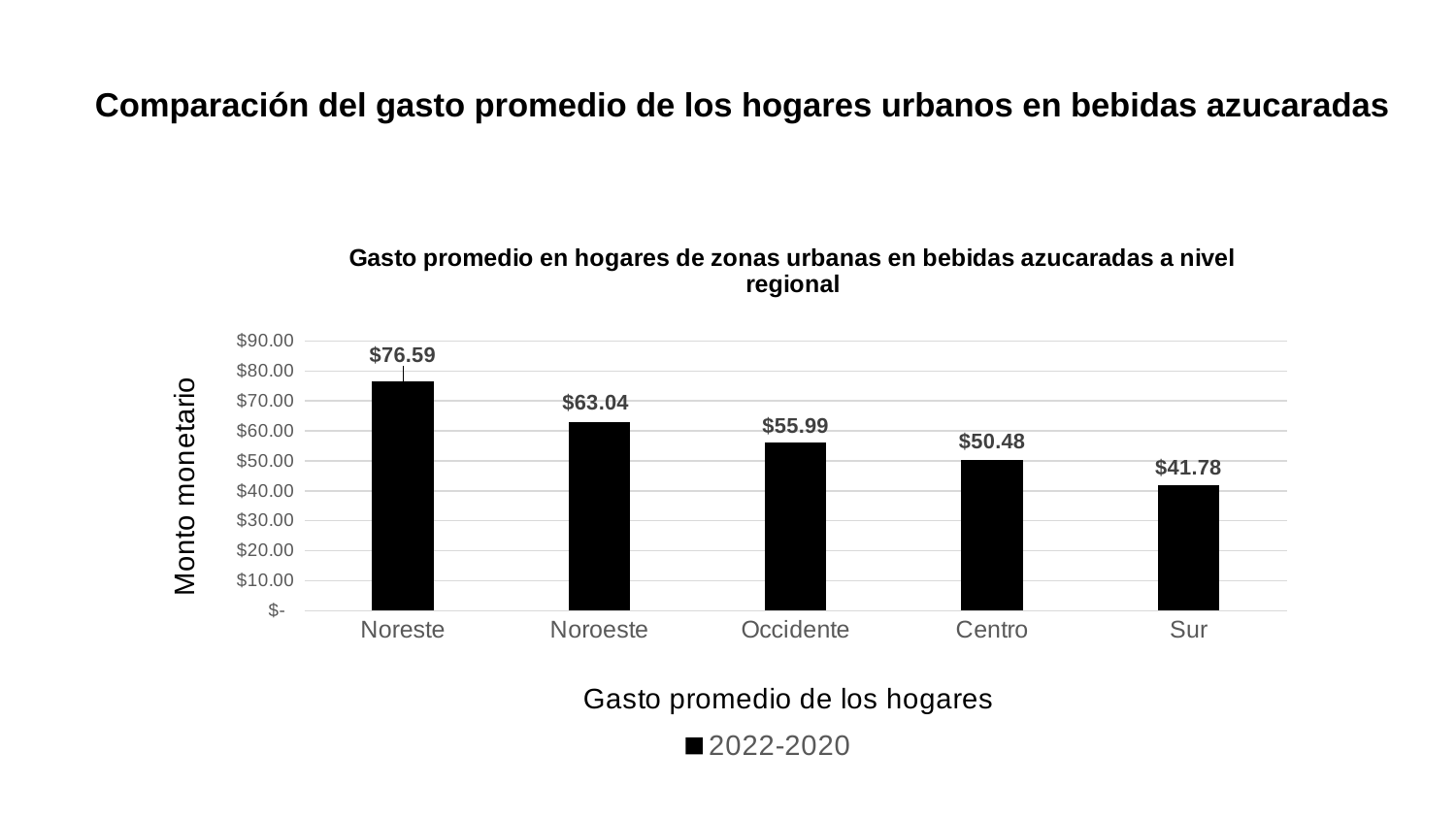
How many regions are shown on the x axis? 5 Which region has the highest value? Noreste What is the difference between the values for Occidente and Sur? $14.21 What is the value for Sur? $41.78 What is the value for Centro? $50.48 Which is larger, the value for Noroeste or the value for Centro? Noroeste What is the value for Noreste? $76.59 What is the difference between the values for Noreste and Noroeste? $13.55 What kind of chart is shown? bar chart Is the value for Occidente greater or less than $60.00? less Which region has the lowest value? Sur How many series does the legend list? 1